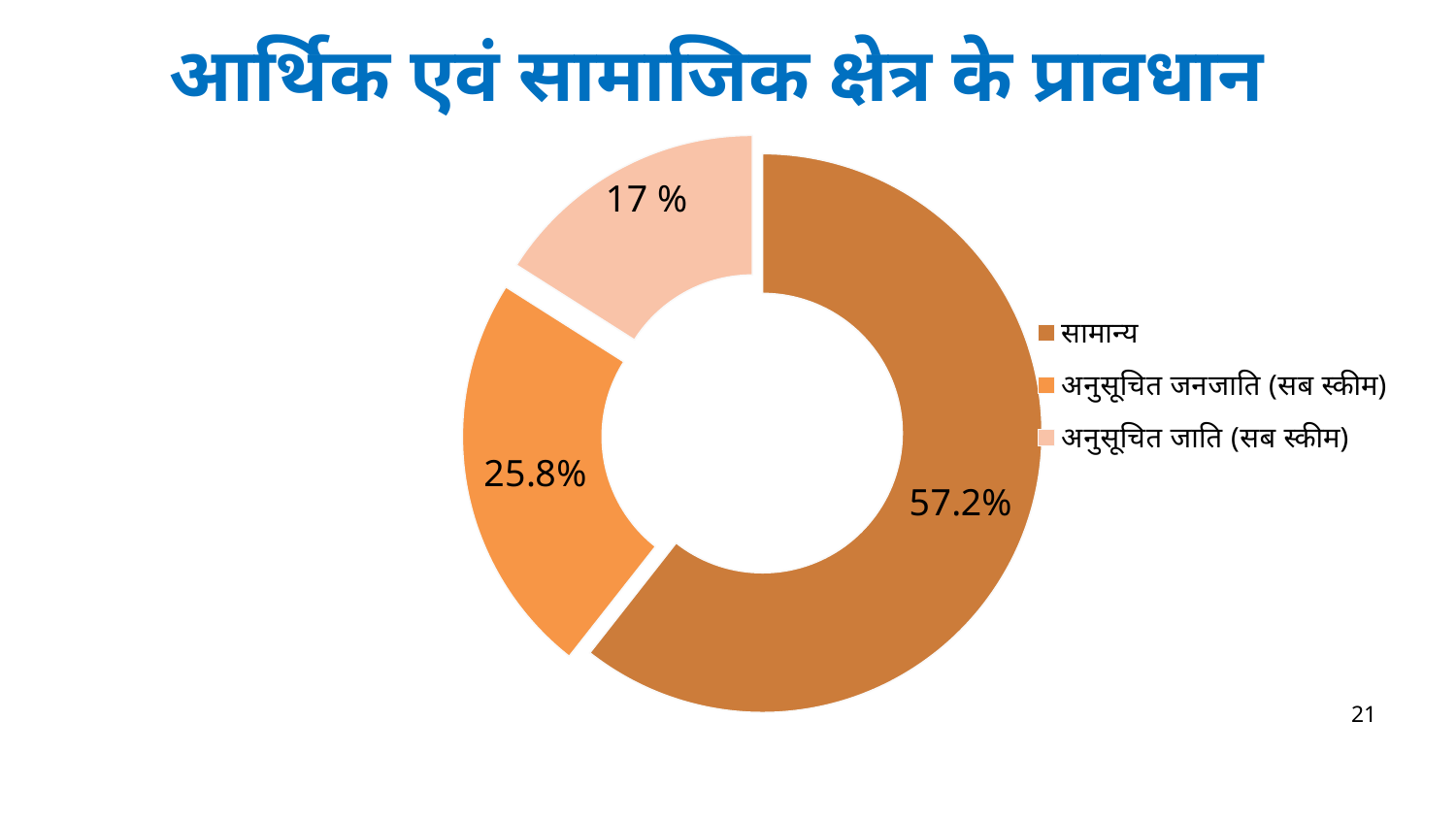
How many categories are shown in the chart? 3 What share of the doughnut chart does the सामान्य slice represent? 57.2% Which category has the largest slice in the chart? सामान्य What value is shown for अनुसूचित जनजाति (सब स्कीम) in the chart? 25.8% Which category has the smallest slice in the chart? अनुसूचित जाति (सब स्कीम) Which is larger: the slice for अनुसूचित जनजाति (सब स्कीम) or the slice for अनुसूचित जाति (सब स्कीम)? अनुसूचित जनजाति (सब स्कीम) What is the title of the slide containing the chart? आर्थिक एवं सामाजिक क्षेत्र के प्रावधान What type of chart is shown on the slide? Doughnut (pie) chart What value is shown for अनुसूचित जाति (सब स्कीम) in the chart? 17 % What is the difference in percentage points between the अनुसूचित जनजाति (सब स्कीम) slice and the अनुसूचित जाति (सब स्कीम) slice? 8.8 Which legend entry is shown with the lightest colour in the chart? अनुसूचित जाति (सब स्कीम) What is the difference in percentage points between the सामान्य slice and the अनुसूचित जनजाति (सब स्कीम) slice? 31.4